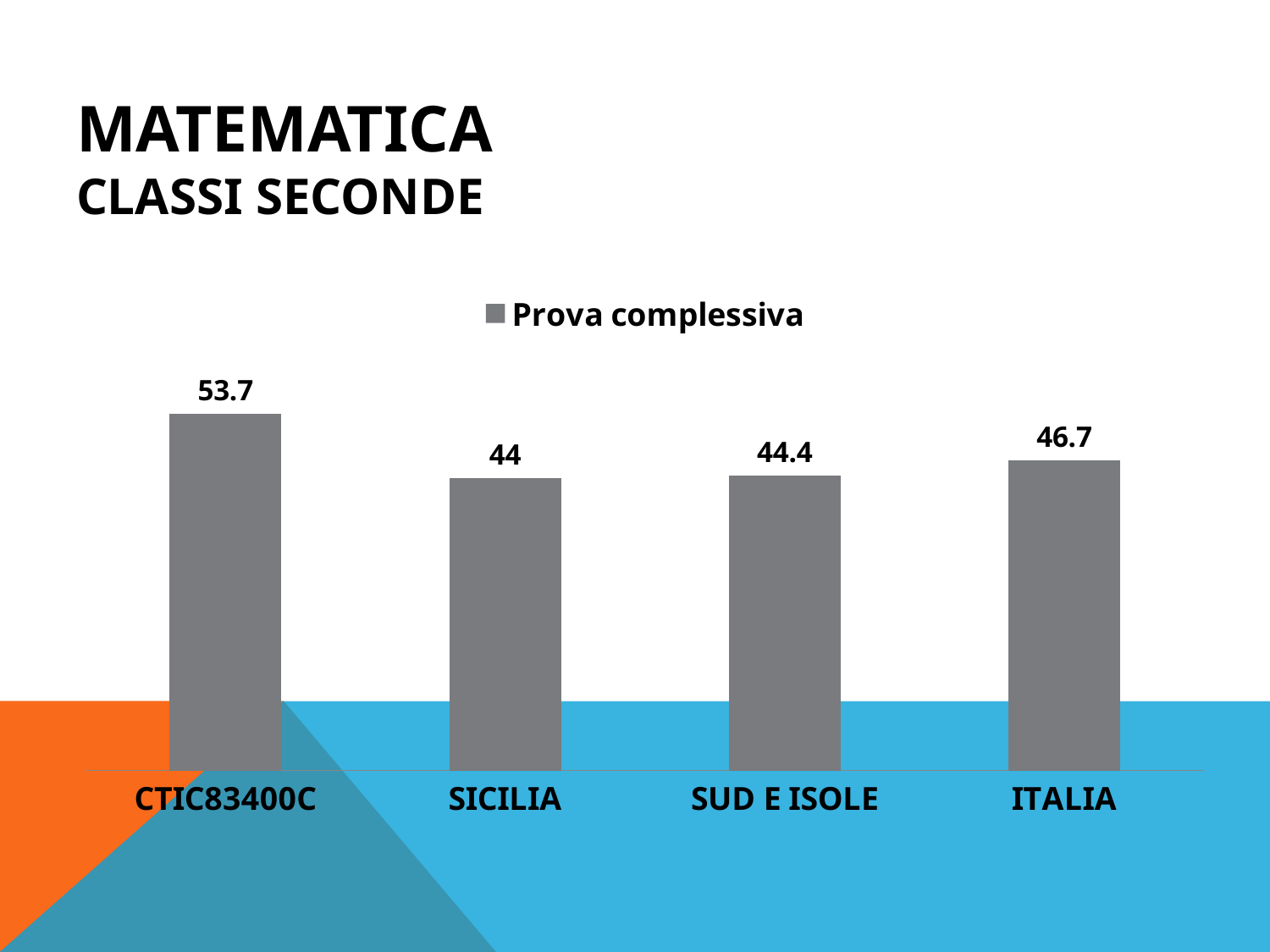
How many series does the legend list? 1 What is the difference between the values for SUD E ISOLE and SICILIA? 0.4 What is the value for SICILIA? 44 What is the difference between the values for CTIC83400C and ITALIA? 7 What is the value for ITALIA? 46.7 What kind of chart is shown on the slide? bar chart Which category has the highest value? CTIC83400C Which is larger, the value for ITALIA or the value for SUD E ISOLE? ITALIA Which category has the lowest value? SICILIA What is the value for SUD E ISOLE? 44.4 How many categories are shown on the x axis? 4 What is the value for CTIC83400C? 53.7